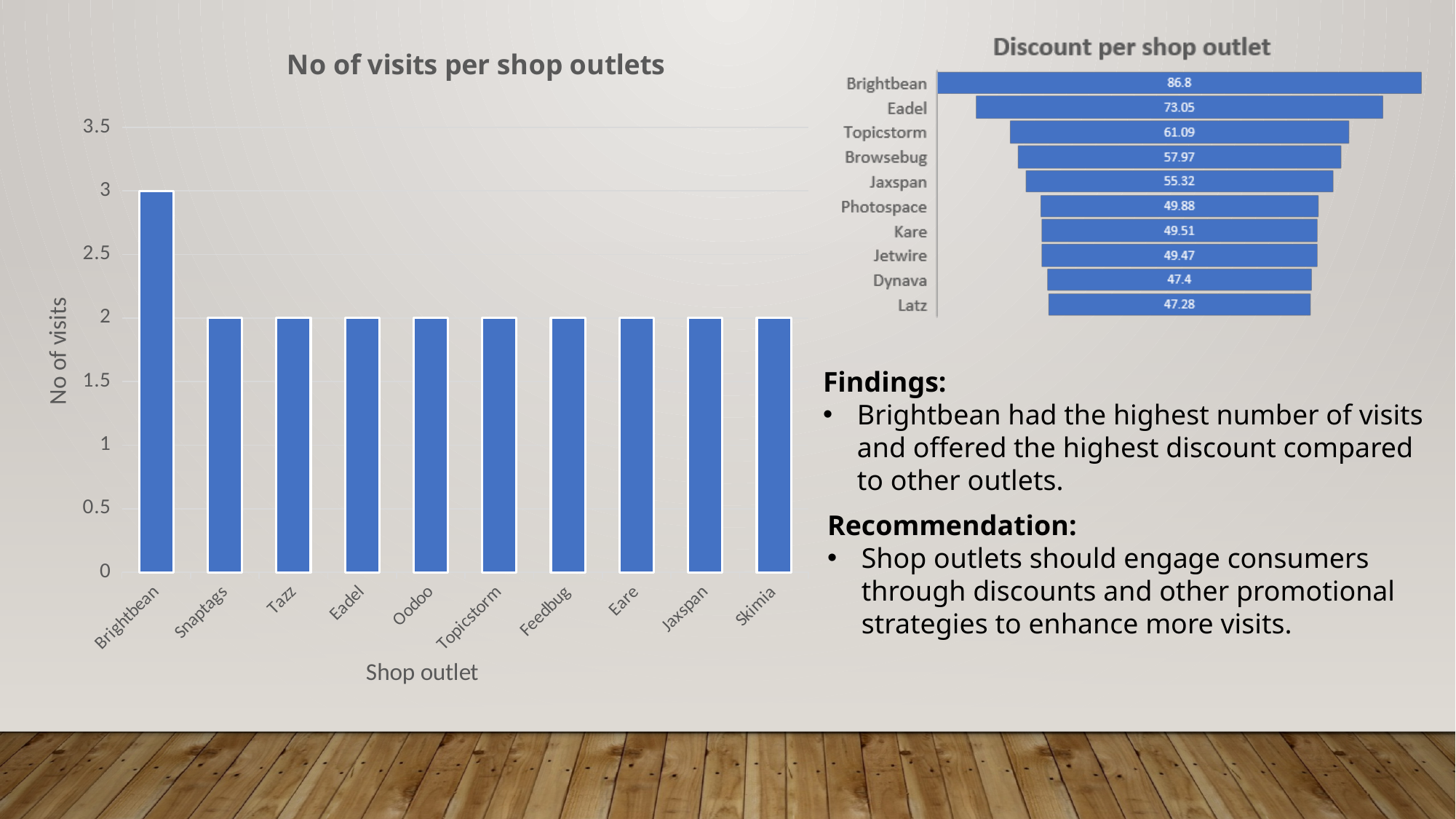
In the 'Discount per shop outlet' chart, what is the discount for Brightbean? 86.8 In the 'Discount per shop outlet' chart, which has the larger discount, Topicstorm or Browsebug? Topicstorm In the 'No of visits per shop outlets' chart, which shop outlet has the highest number of visits? Brightbean In the 'No of visits per shop outlets' chart, what is the number of visits for Brightbean? 3 In the 'No of visits per shop outlets' chart, how many shop outlets are shown on the x axis? 10 In the 'Discount per shop outlet' chart, which shop outlet has the lowest discount? Latz In the 'No of visits per shop outlets' chart, what is the label of the y axis? No of visits What kind of chart is 'No of visits per shop outlets'? Bar chart In the 'Discount per shop outlet' chart, what is the difference between the discounts for Brightbean and Eadel? 13.75 In the 'Discount per shop outlet' chart, what is the discount for Jaxspan? 55.32 In the 'No of visits per shop outlets' chart, what is the number of visits for Snaptags? 2 In the 'Discount per shop outlet' chart, how many shop outlets are listed? 10